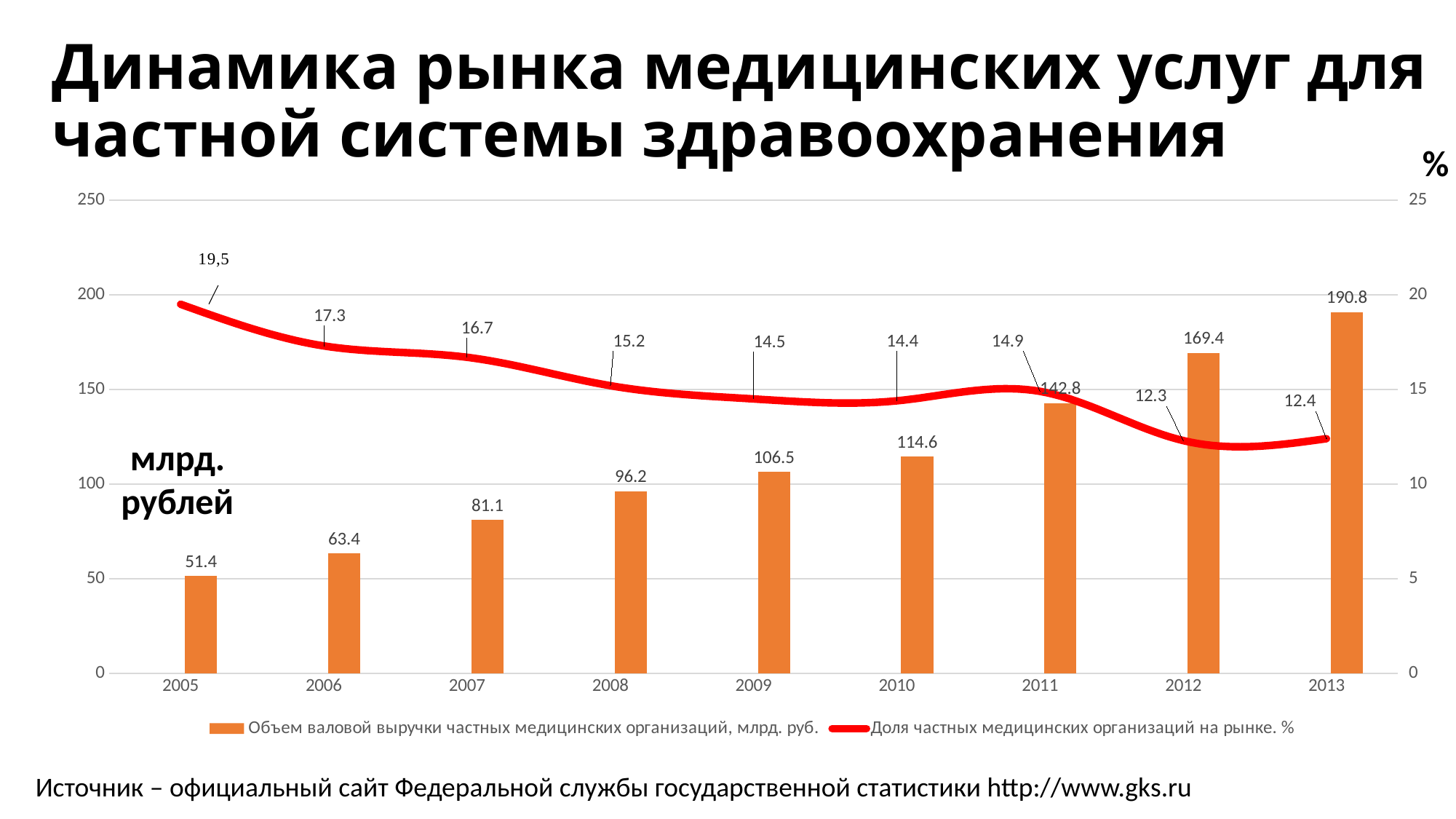
Which is larger, the market share in 2005 or in 2013? 2005 What is the gross revenue value shown for 2013? 190.8 What is the overall trend of the market share line from 2005 to 2013? falling What is the market share of private medical organisations (Доля частных медицинских организаций на рынке) in 2007? 16.7 What colour are the bars for gross revenue? orange How many years are shown on the x axis? 9 How many series does the legend list? 2 What is the difference in gross revenue between 2012 and 2011? 26.6 Which year has the lowest market share of private medical organisations? 2012 Is the gross revenue for 2010 greater or less than 100? greater Which year has the highest gross revenue of private medical organisations? 2013 What is the gross revenue of private medical organisations (Объем валовой выручки) in 2009? 106.5